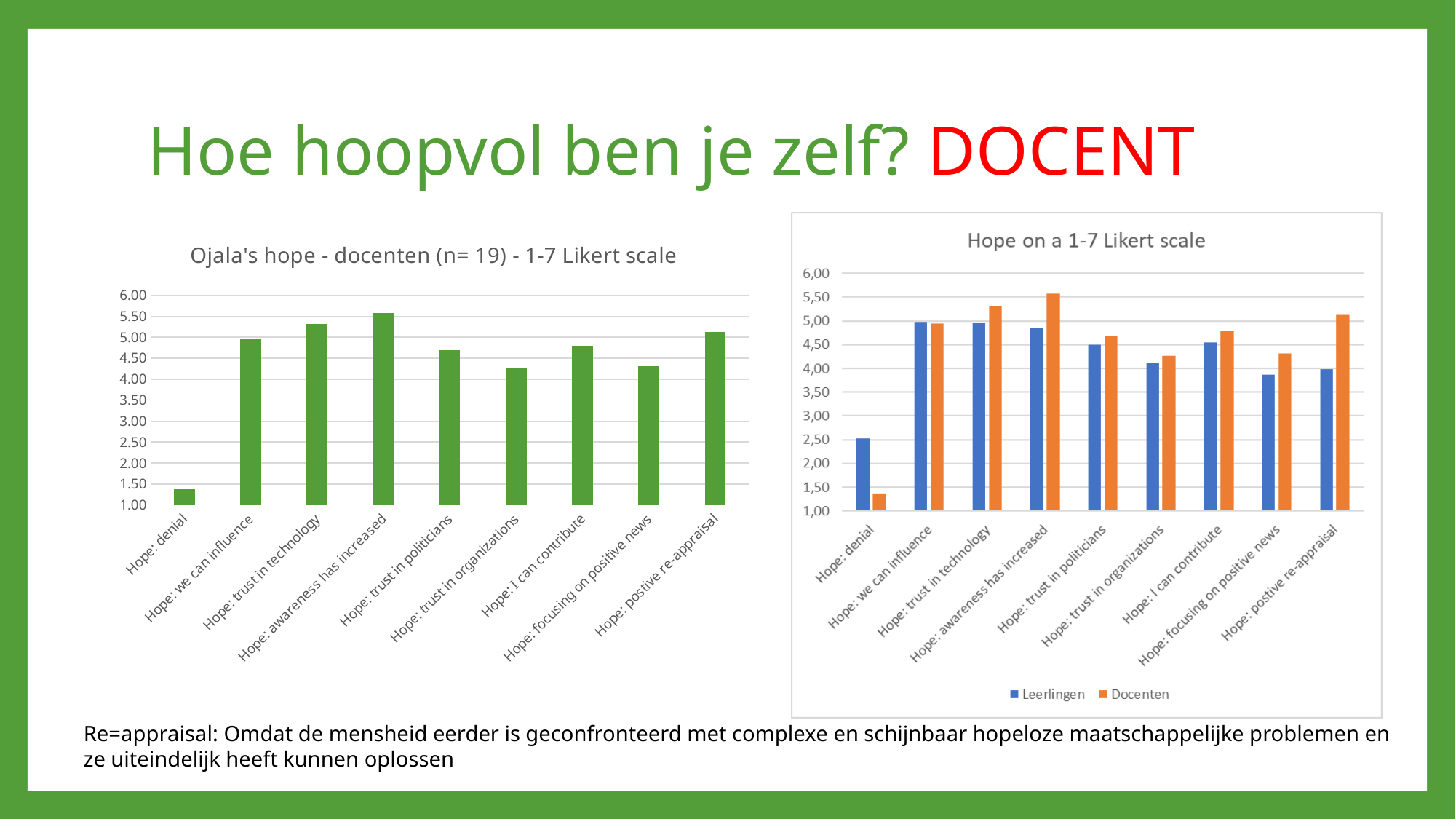
In the right chart (Hope on a 1-7 Likert scale), for Hope: awareness has increased, which series has the larger value, Leerlingen or Docenten? Docenten In the right chart (Hope on a 1-7 Likert scale), for Hope: denial, which series has the larger value, Leerlingen or Docenten? Leerlingen In the left chart (Ojala's hope - docenten), which category has the lowest value? Hope: denial In the left chart (Ojala's hope - docenten), is the value for Hope: awareness has increased greater or less than 5.00? greater In the left chart (Ojala's hope - docenten), how many categories are shown? 9 In the left chart (Ojala's hope - docenten), is the value for Hope: trust in organizations greater or less than 4.50? less In the right chart (Hope on a 1-7 Likert scale), is the Leerlingen value for Hope: focusing on positive news greater or less than 4.50? less What kind of chart is the left chart titled "Ojala's hope - docenten (n= 19) - 1-7 Likert scale"? bar chart In the left chart (Ojala's hope - docenten), which category has the highest value? Hope: awareness has increased In the right chart (Hope on a 1-7 Likert scale), what are the two series named in the legend? Leerlingen and Docenten In the right chart titled "Hope on a 1-7 Likert scale", how many series does the legend list? 2